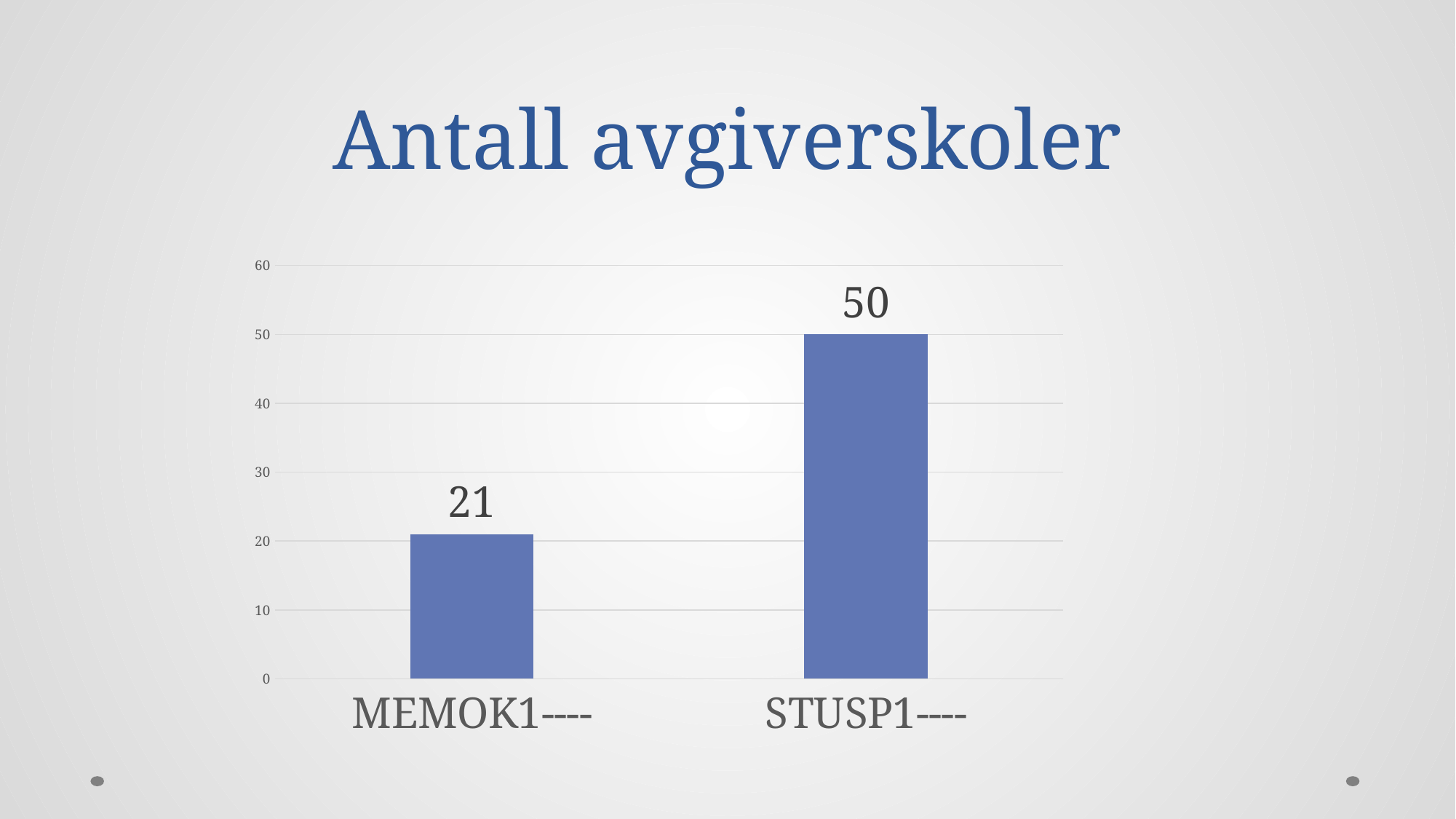
Is the value for MEMOK1---- greater or less than 30? less What is the value for MEMOK1----? 21 How many categories are shown in the chart? 2 What is the difference between the values for STUSP1---- and MEMOK1----? 29 What is the highest value shown on the vertical axis? 60 Which category has the lowest value? MEMOK1---- Is the value for STUSP1---- greater or less than 40? greater What is the title of the slide? Antall avgiverskoler What kind of chart is shown on the slide? bar chart What is the value for STUSP1----? 50 Which category has the highest value? STUSP1---- Which is larger, the value for MEMOK1---- or the value for STUSP1----? STUSP1----